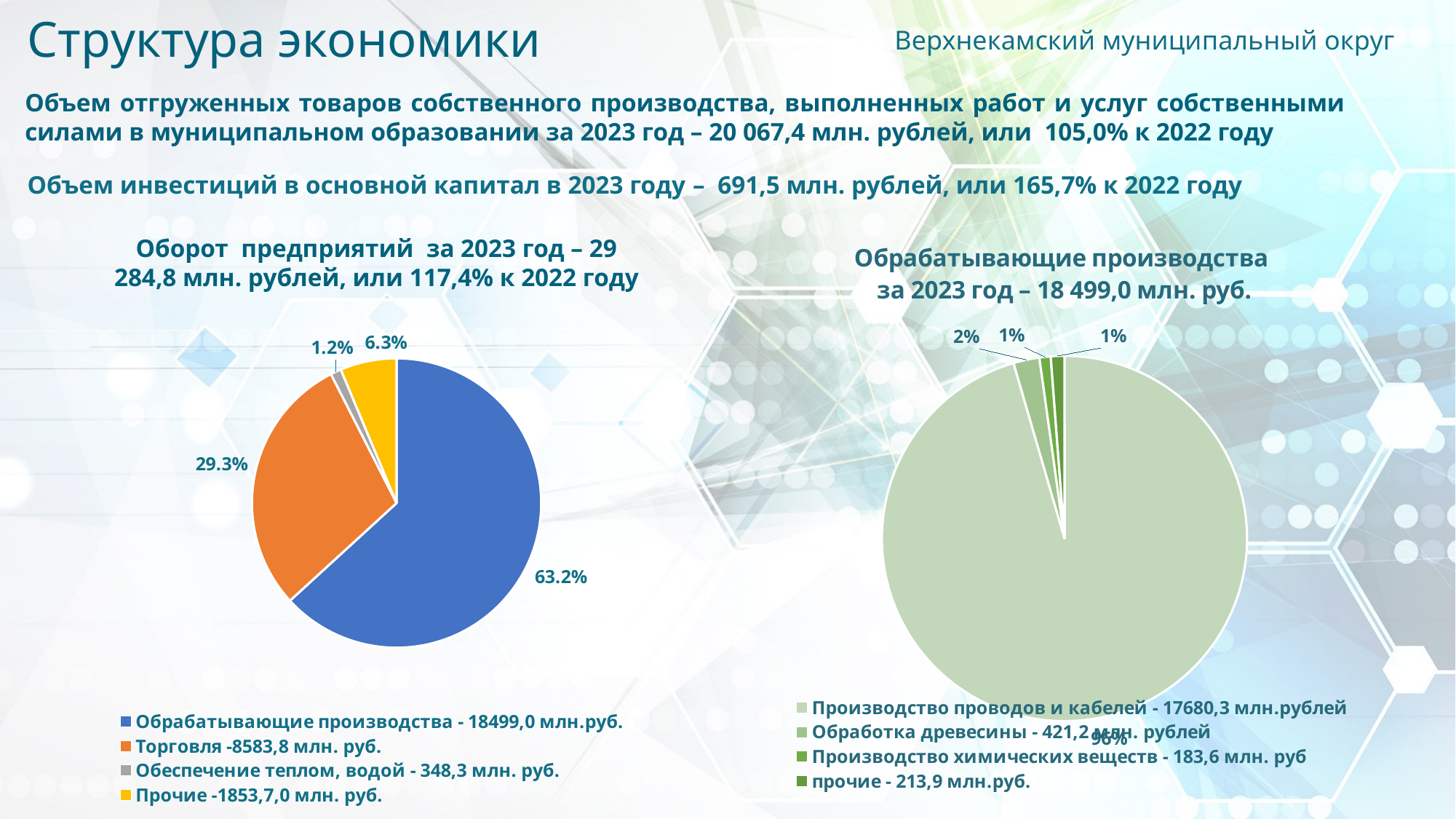
In the right pie chart (Обрабатывающие производства), what value does the legend give for 'Производство химических веществ'? 183,6 млн. руб In the left pie chart (Оборот предприятий), what share does 'Торговля' have? 29.3% In the right pie chart (Обрабатывающие производства), which category has the largest slice? Производство проводов и кабелей In the right pie chart (Обрабатывающие производства), what share does 'Обработка древесины' have? 2% In the left pie chart (Оборот предприятий), how many slices are there? 4 In the left pie chart (Оборот предприятий), what is the difference in percentage points between 'Обрабатывающие производства' and 'Торговля'? 33.9 How many entries does the legend of the right pie chart (Обрабатывающие производства) list? 4 In the left pie chart (Оборот предприятий), what value in млн. руб. does the legend give for 'Торговля'? 8583,8 млн. руб. In the left pie chart (Оборот предприятий), what share does 'Прочие' have? 6.3% In the left pie chart (Оборот предприятий), which category has the smallest slice? Обеспечение теплом, водой What kind of chart is the left chart titled 'Оборот предприятий за 2023 год'? pie chart